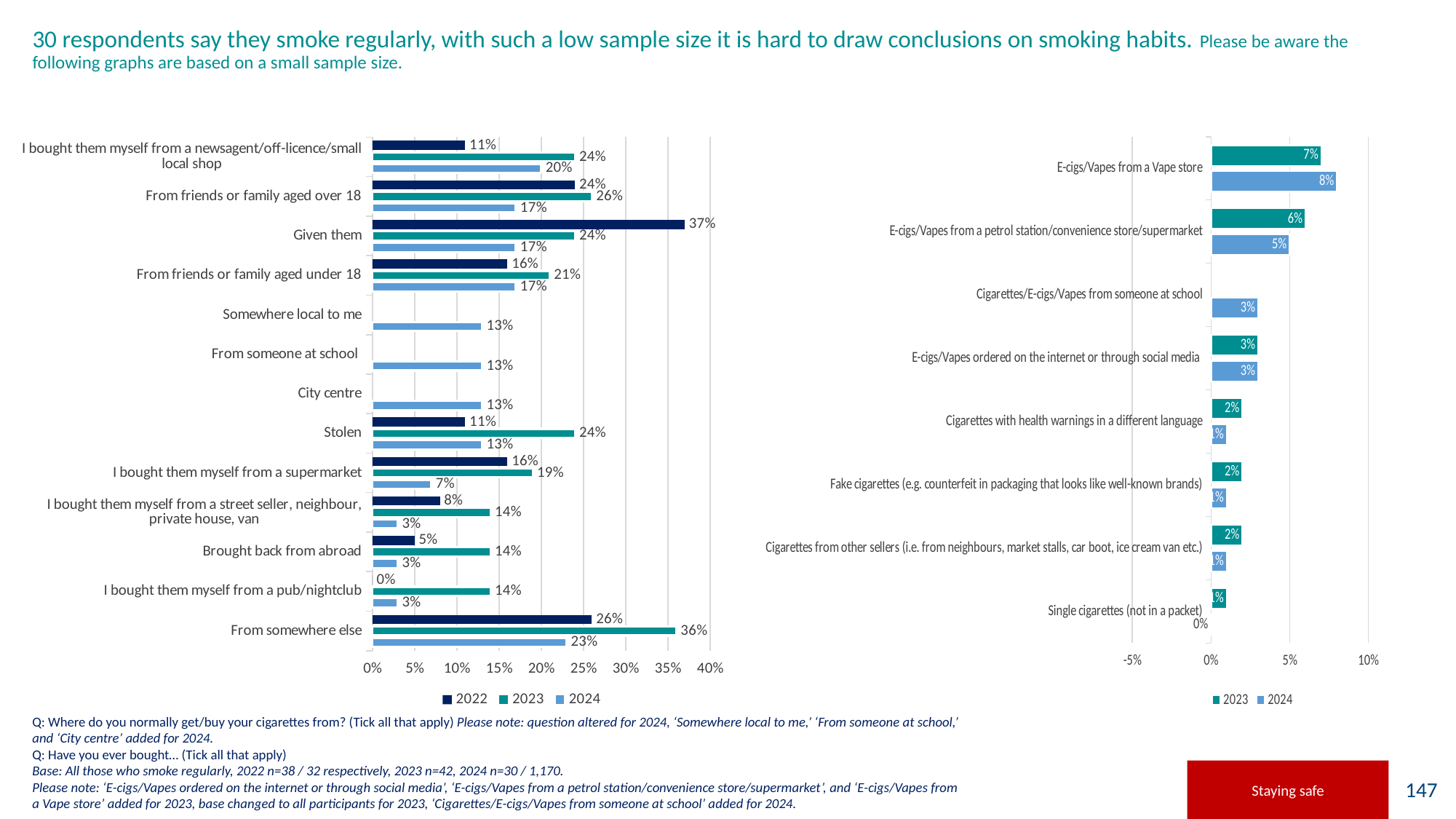
In the left chart, what is the 2022 value for 'Given them'? 37% How many series does the legend of the left chart list? 3 In the left chart, what is the 2024 value for 'I bought them myself from a supermarket'? 7% In the left chart, which is larger for 'From friends or family aged over 18': the 2022 value or the 2024 value? 2022 In the left chart, what is the difference between the 2023 and 2024 values for 'Stolen'? 11% In the right chart, what is the 2023 value for 'E-cigs/Vapes from a petrol station/convenience store/supermarket'? 6% In the right chart, which category has the highest 2024 value? E-cigs/Vapes from a Vape store In the left chart, what is the 2023 value for 'From somewhere else'? 36% In the left chart, which category has the lowest 2022 value? I bought them myself from a pub/nightclub In the left chart, which category has the highest 2022 value? Given them What type of chart is the right chart? Bar chart In the right chart, what is the 2024 value for 'E-cigs/Vapes from a Vape store'? 8%